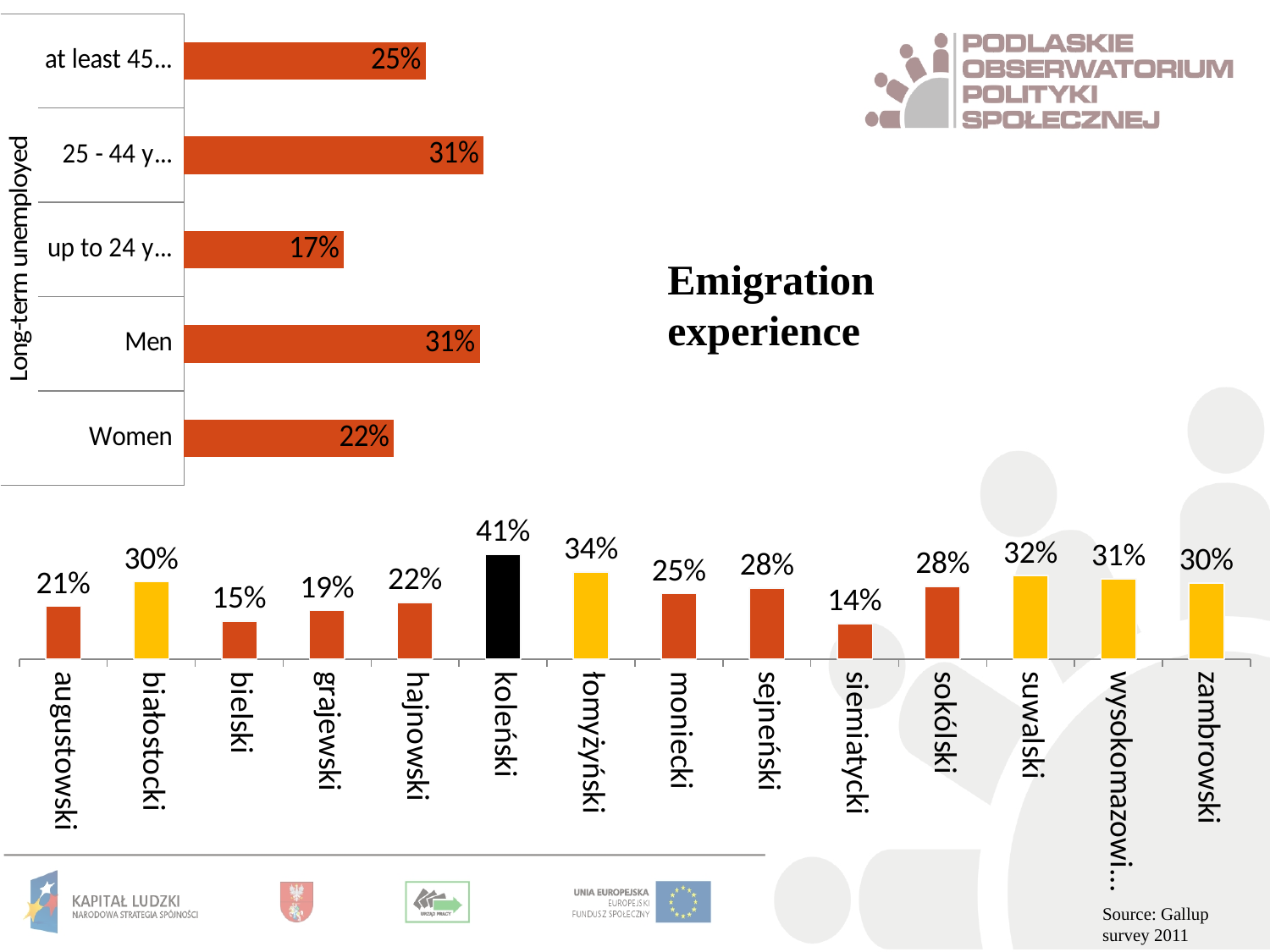
In the top-left chart, what is the value for Men? 31% In the bottom chart, which district has the highest value? koleński In the top-left chart, how many categories are shown? 5 In the top-left chart, what is the value for Women? 22% In the bottom chart, how many districts are shown? 14 What kind of chart is the top-left chart? bar chart In the bottom chart, which district has the lowest value? siemiatycki In the top-left chart, which category has the lowest value? up to 24 y... In the top-left chart, what is the difference between the values for Men and Women? 9%